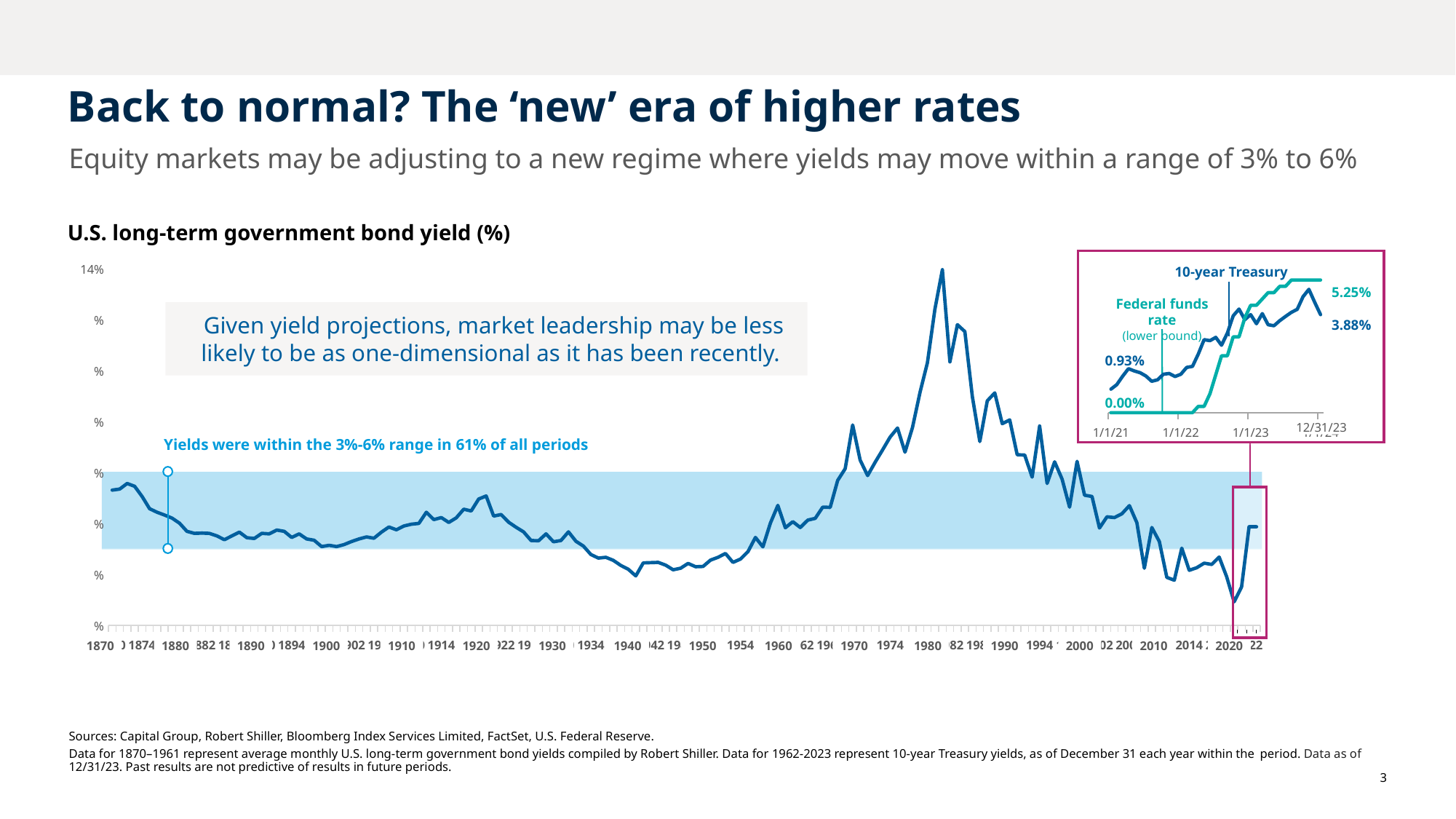
In the inset chart, what is the 10-year Treasury yield at the start of the period (1/1/21)? 0.93% What kind of chart is the main chart titled 'U.S. long-term government bond yield (%)'? Line chart In the inset chart, by how much did the 10-year Treasury yield rise from 1/1/21 (0.93%) to 12/31/23 (3.88%)? 2.95 percentage points In the inset chart, what is the Federal funds rate (lower bound) at the end of the period (12/31/23)? 5.25% In the inset chart, what is the 10-year Treasury yield at the end of the period (12/31/23)? 3.88% In the inset chart, does the Federal funds rate rise or fall over the period shown? Rise In the inset chart, which series is higher at 12/31/23: the 10-year Treasury or the Federal funds rate? Federal funds rate According to the annotation on the main chart, in what percentage of all periods were yields within the 3%-6% range? 61% In the inset chart, what is the Federal funds rate (lower bound) at the start of the period (1/1/21)? 0.00% In which decade does the main chart's bond yield line reach its highest point? 1980s In the inset chart, what is the difference between the Federal funds rate (5.25%) and the 10-year Treasury yield (3.88%) at 12/31/23? 1.37 percentage points How many series are plotted in the inset chart in the upper right? 2